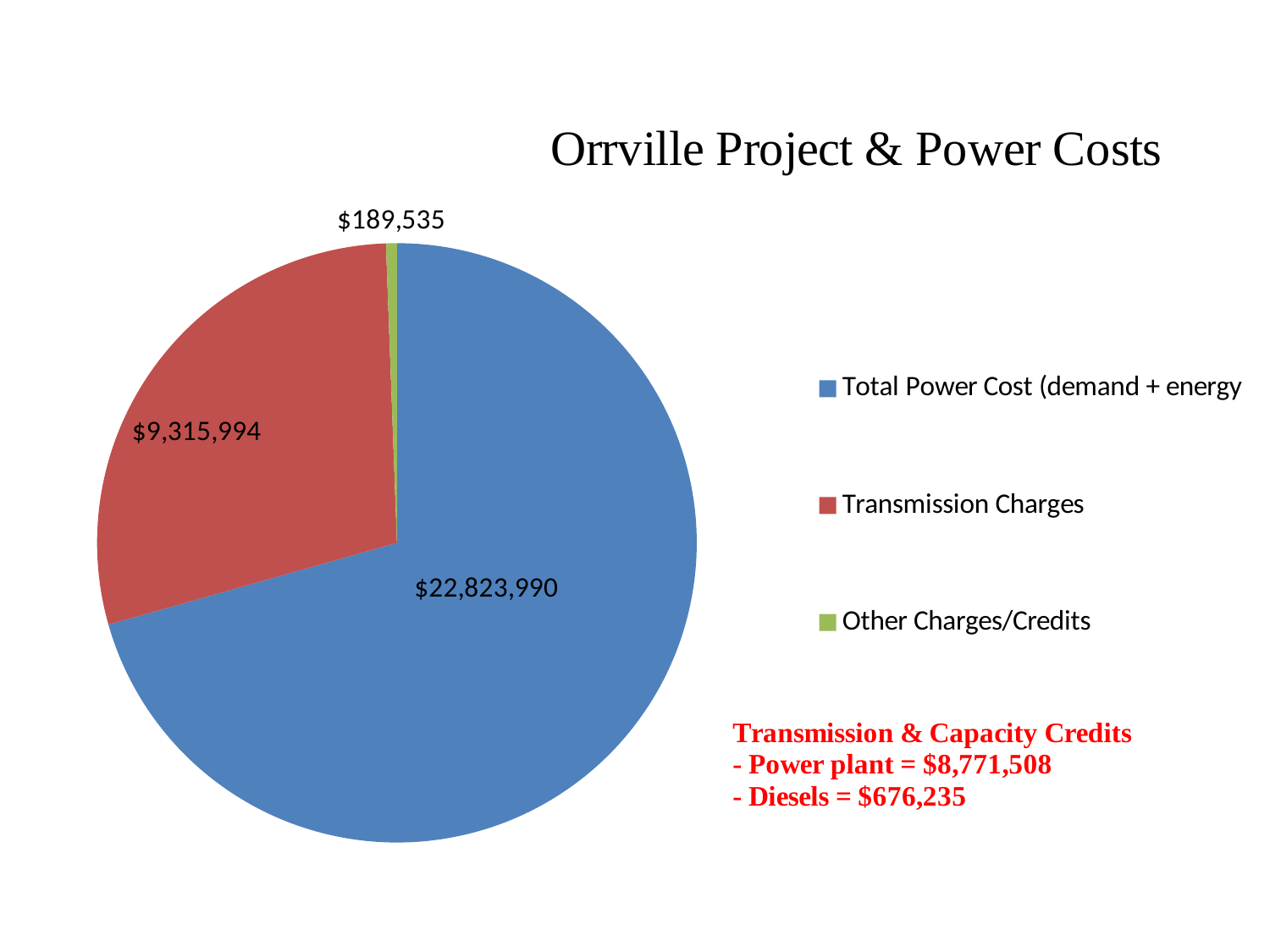
Which category has the smallest slice of the pie? Other Charges/Credits What is the difference between the Transmission Charges value and the Other Charges/Credits value? $9,126,459 What is the value of the Transmission Charges slice? $9,315,994 What is the difference between the Total Power Cost (demand + energy) value and the Transmission Charges value? $13,507,996 What is the value of the Total Power Cost (demand + energy) slice? $22,823,990 What is the value of the Other Charges/Credits slice? $189,535 Which is larger, Transmission Charges or Other Charges/Credits? Transmission Charges What is the title of the chart? Orrville Project & Power Costs What type of chart is shown on the slide? Pie chart What colour is the Transmission Charges slice? Red Which category has the largest slice of the pie? Total Power Cost (demand + energy) How many slices does the pie chart have? 3